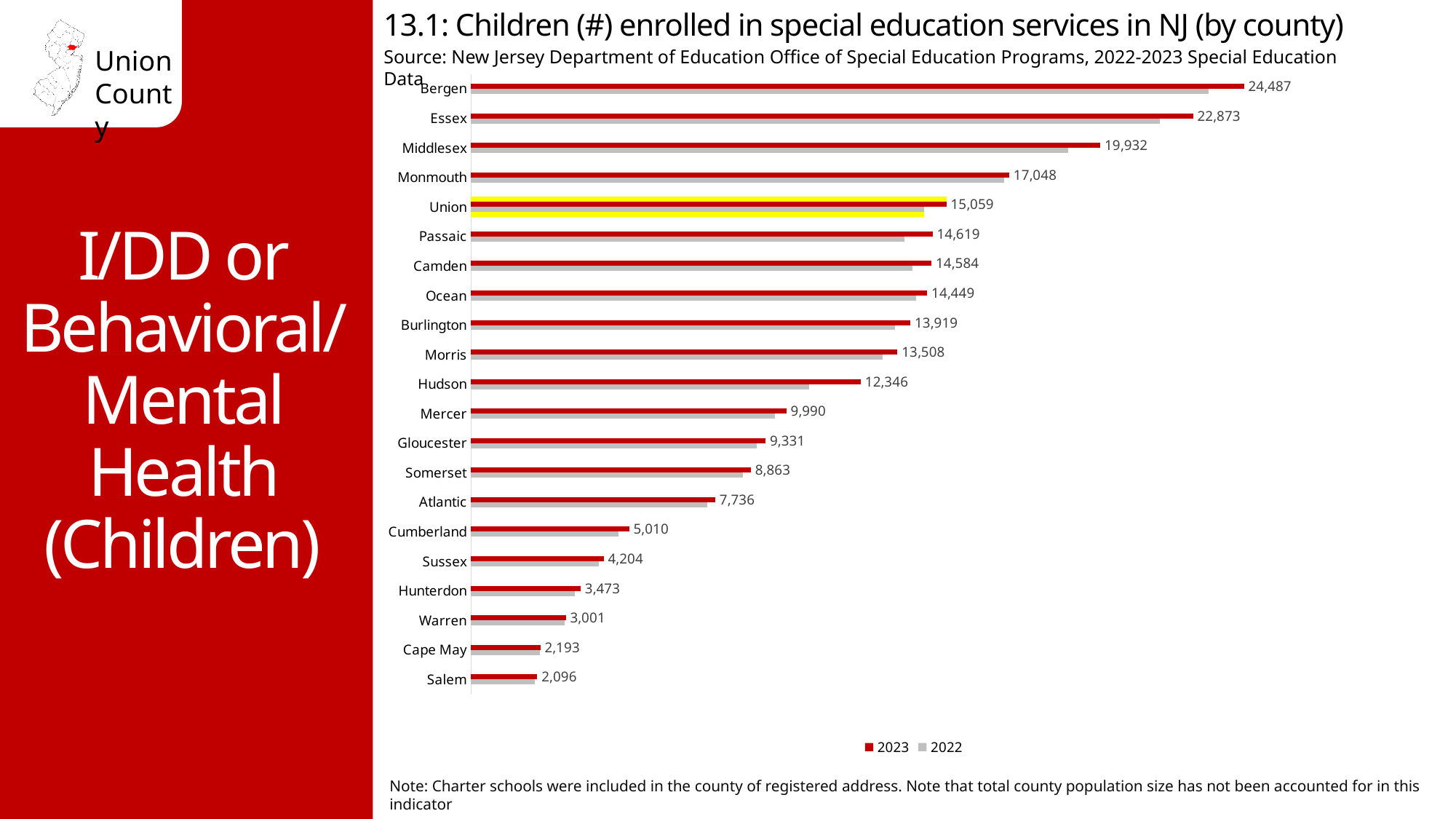
Which county has the highest 2023 value? Bergen How many counties are shown in the chart? 21 Which county's bars are highlighted in yellow? Union Which has a larger 2023 value, Monmouth or Union? Monmouth How many series does the legend list? 2 Which county has the lowest 2023 value? Salem What is the 2023 value for Salem county? 2,096 What is the 2023 value for Union county? 15,059 What is the difference between the 2023 values for Bergen and Essex? 1,614 What is the difference between the 2023 values for Hudson and Mercer? 2,356 What kind of chart is shown on the slide? Bar chart What is the 2023 value for Bergen county? 24,487